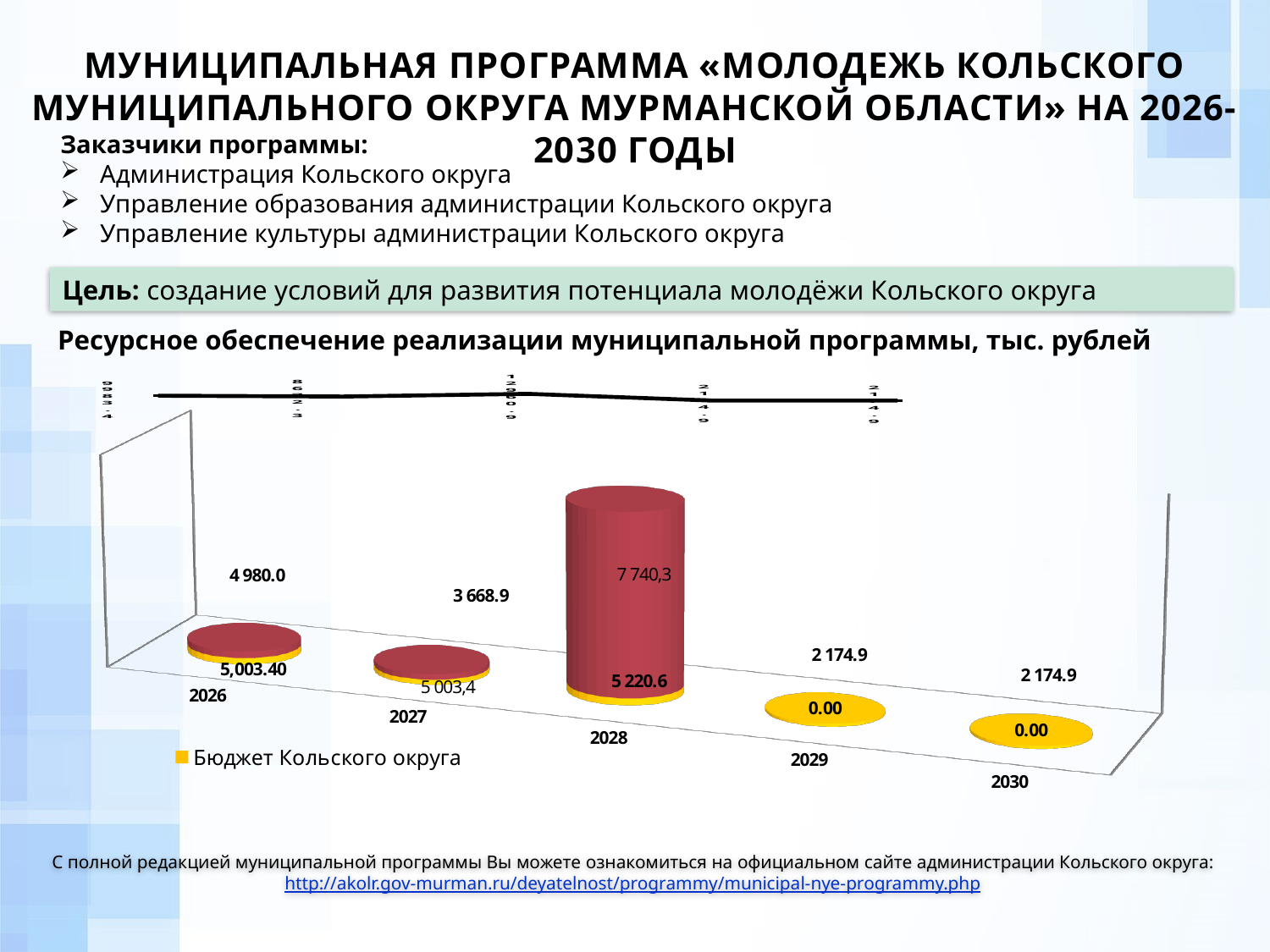
What is the value of Бюджет Кольского округа for 2026? 4 980.0 How many years are shown along the x axis of the chart? 5 What is the value of Бюджет Кольского округа for 2028? 5 220.6 What is the value of Бюджет Кольского округа for 2027? 3 668.9 What is the value of Бюджет Кольского округа for 2029? 2 174.9 Which year has the larger value of Бюджет Кольского округа, 2026 or 2028? 2028 What series name is shown in the chart legend? Бюджет Кольского округа What kind of chart is shown on the slide? bar chart What is the difference between the Бюджет Кольского округа values for 2028 and 2026? 240.6 In which year is the value of Бюджет Кольского округа highest? 2028 What is the title of the chart on the slide? Ресурсное обеспечение реализации муниципальной программы, тыс. рублей What is the value of Бюджет Кольского округа for 2030? 2 174.9